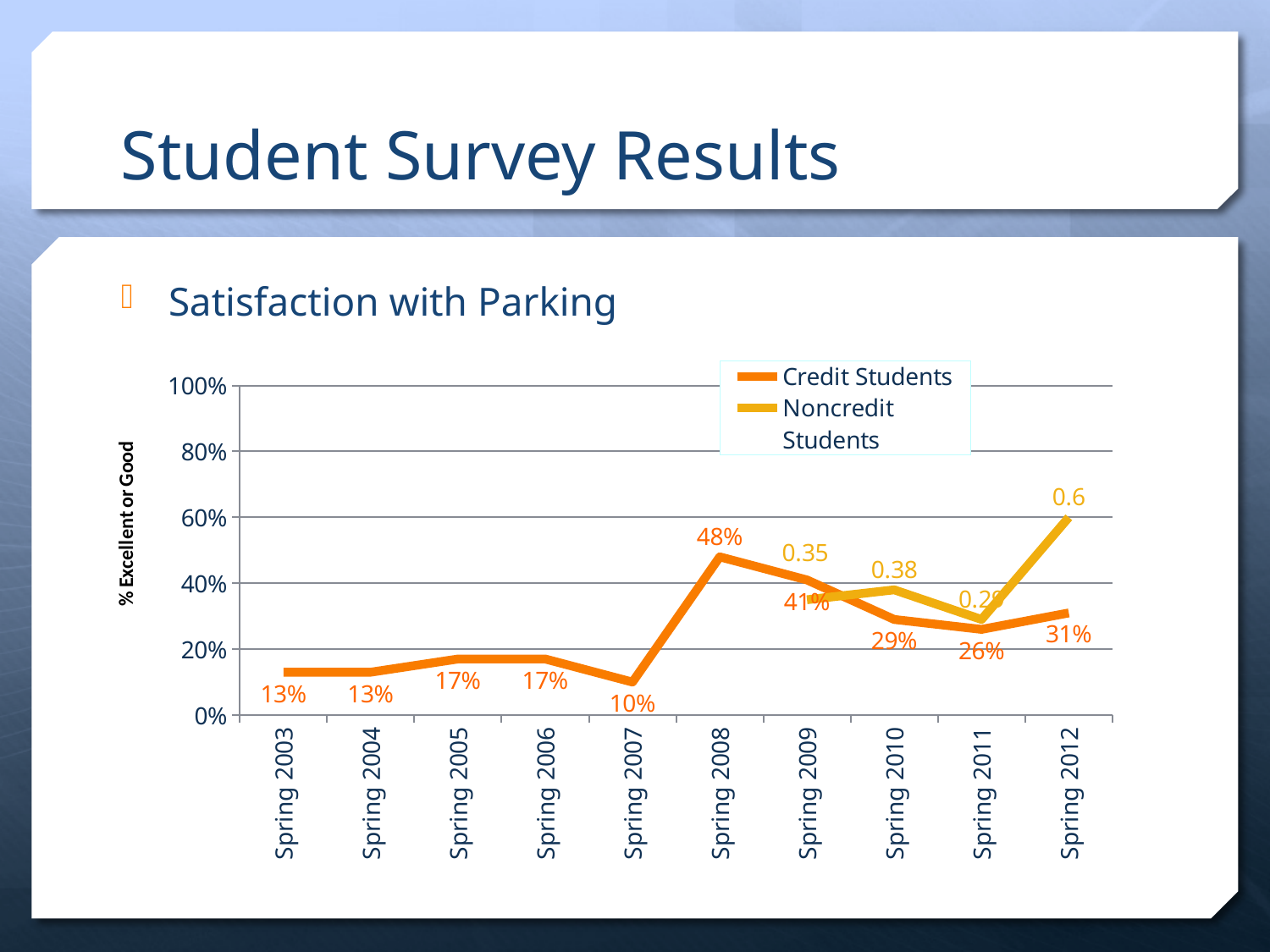
Which is larger in Spring 2012, the Credit Students value or the Noncredit Students value? Noncredit Students What kind of chart is shown on the slide? line chart In which year is the Credit Students value lowest? Spring 2007 What is the value for Credit Students in Spring 2007? 10% What is the difference between the Credit Students values for Spring 2008 and Spring 2009? 7% What is the label on the y axis? % Excellent or Good How many series does the legend list? 2 What is the value for Noncredit Students in Spring 2010? 0.38 In which year is the Credit Students value highest? Spring 2008 What is the value for Credit Students in Spring 2008? 48% How many years are shown on the x axis? 10 What is the value for Noncredit Students in Spring 2012? 0.6